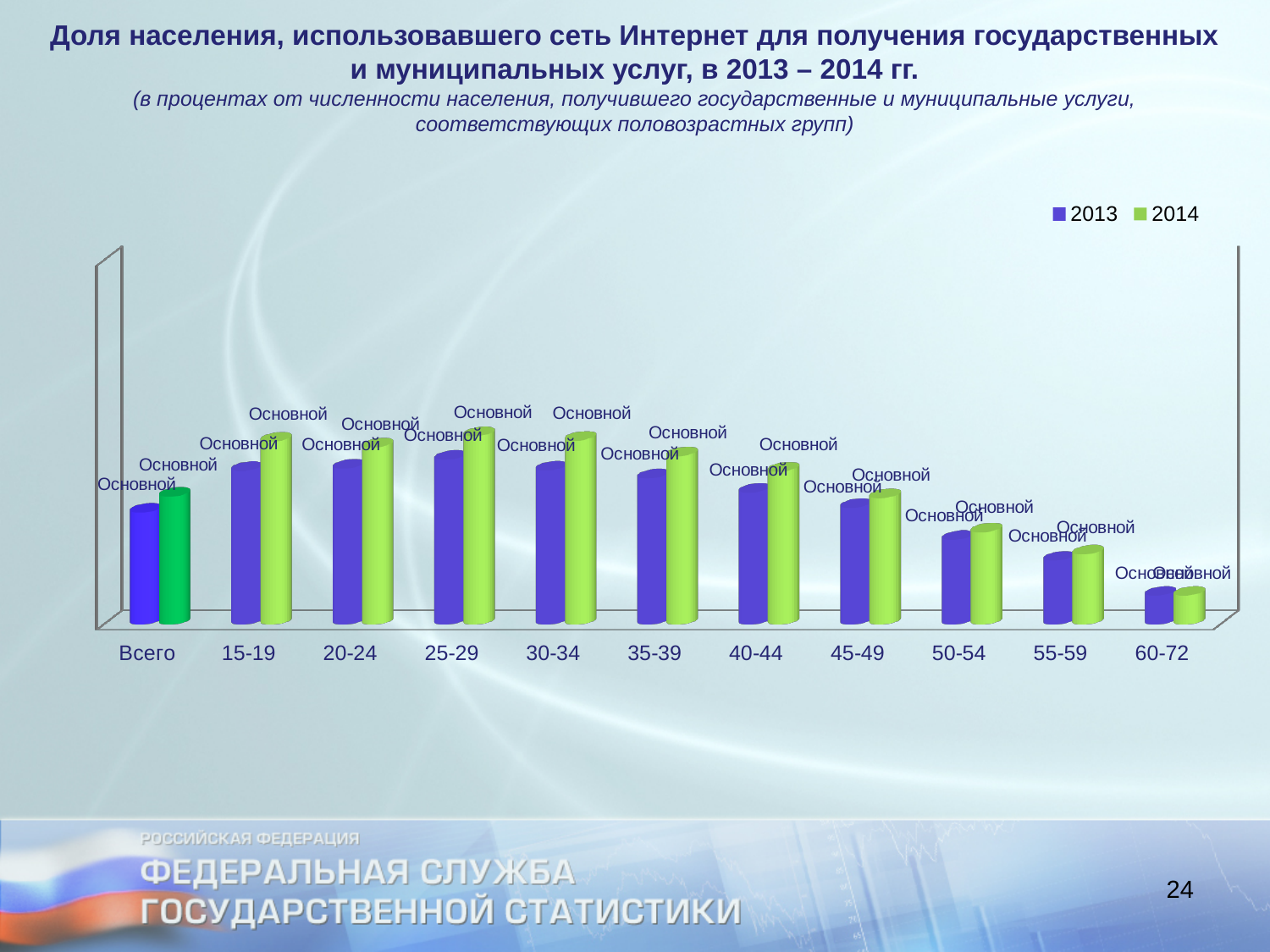
Which age group has the larger 2014 value, 15-19 or 60-72? 15-19 What is the first category on the x axis? Всего Which years are listed in the legend? 2013 and 2014 How many series does the legend list? 2 Do the 2014 values generally rise or fall from the 25-29 age group to the 60-72 age group? fall Which age group has the larger 2013 value, 35-39 or 55-59? 35-39 Is the 2013 value for 45-49 larger or smaller than the 2013 value for 40-44? smaller What kind of chart is shown on the slide? bar chart Which age group has the lowest values for both years? 60-72 How many categories are shown along the x axis? 11